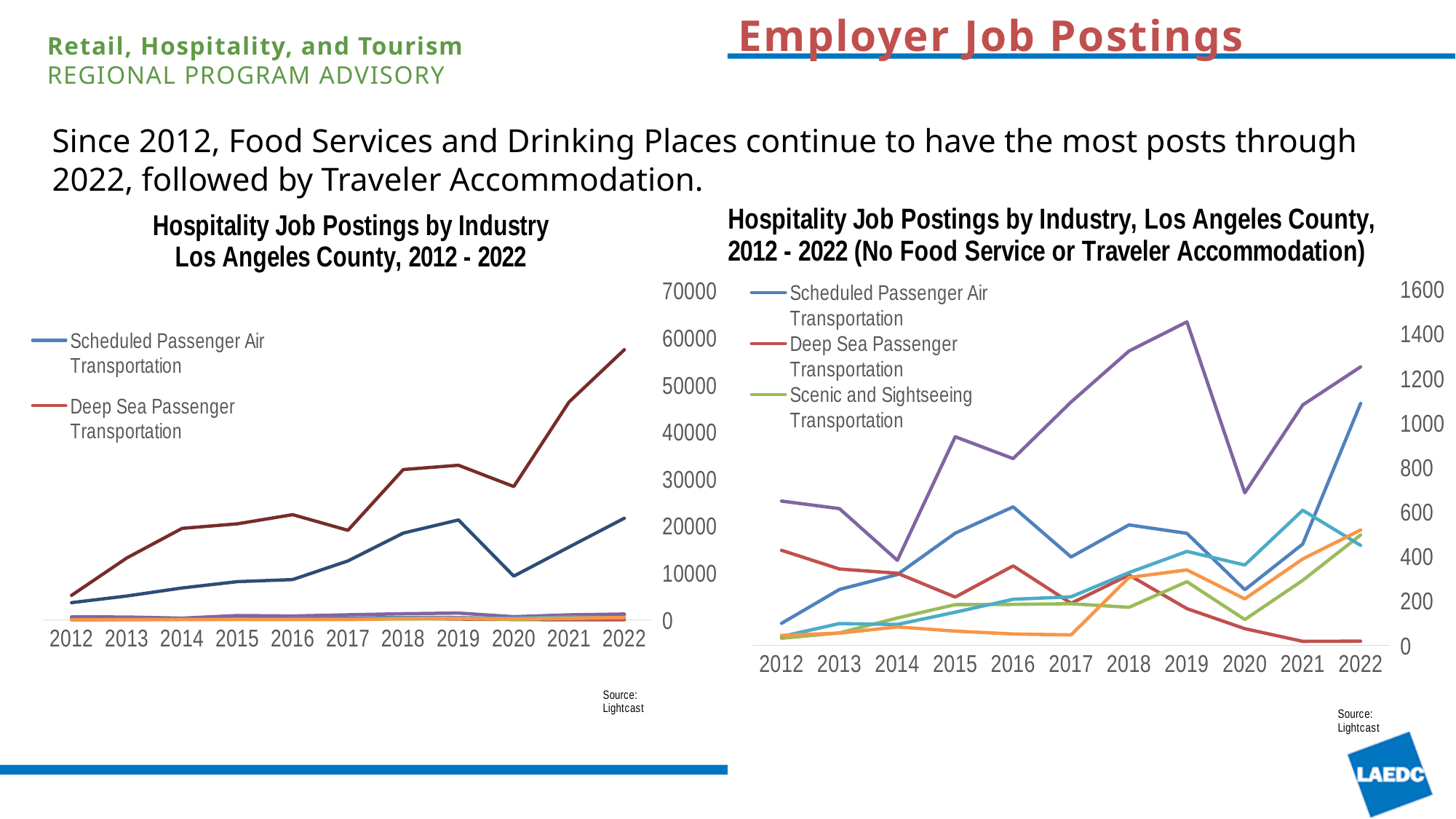
In the left chart, how many years are shown on the x axis? 11 In the right chart, in which year is Scheduled Passenger Air Transportation at its highest? 2022 In the right chart, which is larger in 2022: Scheduled Passenger Air Transportation or Deep Sea Passenger Transportation? Scheduled Passenger Air Transportation In the right chart, is the value for Scenic and Sightseeing Transportation in 2022 greater or less than 200? greater In the right chart, is the value for Scheduled Passenger Air Transportation in 2022 greater or less than 1000? greater In the right chart, is the value for Scheduled Passenger Air Transportation in 2012 greater or less than 200? less What kind of chart is the right chart, 'Hospitality Job Postings by Industry, Los Angeles County, 2012 - 2022 (No Food Service or Traveler Accommodation)'? Line chart In the right chart, how many years are shown on the x axis? 11 In the right chart (No Food Service or Traveler Accommodation), how many series does the legend list? 3 In the right chart, does Deep Sea Passenger Transportation rise or fall from 2019 to 2022? Fall What kind of chart is the left chart, 'Hospitality Job Postings by Industry Los Angeles County, 2012 - 2022'? Line chart